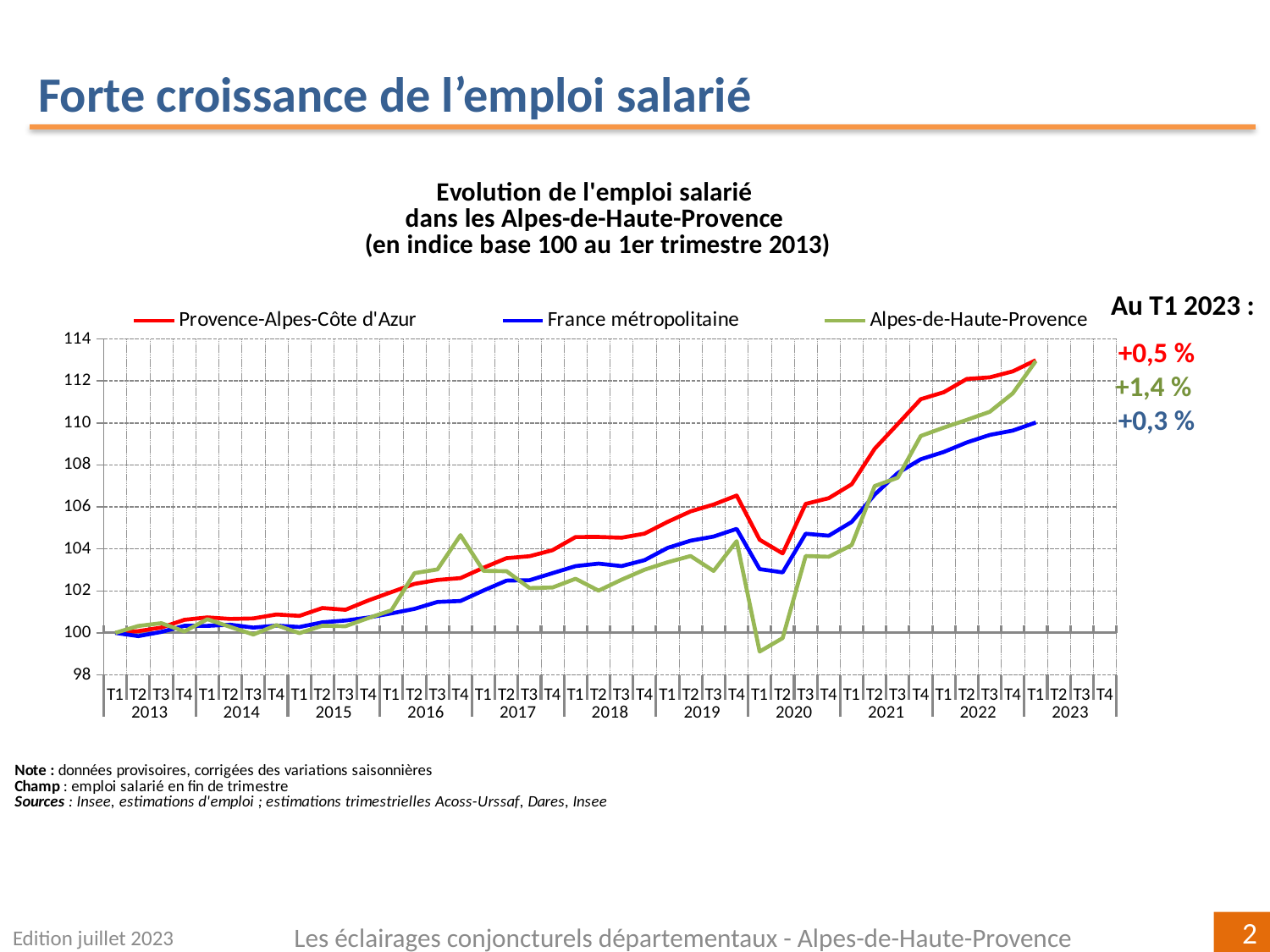
Which series falls to the lowest value during 2020? Alpes-de-Haute-Provence Is the value for Provence-Alpes-Côte d'Azur at T1 2023 greater or less than 112? greater At T1 2023, which is higher: Provence-Alpes-Côte d'Azur or France métropolitaine? Provence-Alpes-Côte d'Azur What kind of chart is shown on the slide? line chart How many series does the legend list? 3 According to the annotation at T1 2023, what is the change for Provence-Alpes-Côte d'Azur? +0,5 % Which series is drawn in green in the chart? Alpes-de-Haute-Provence According to the annotation at T1 2023, what is the change for Alpes-de-Haute-Provence? +1,4 % Is the value for France métropolitaine at T1 2023 greater or less than 108? greater Is the value for Alpes-de-Haute-Provence at T1 2020 greater or less than 100? less According to the annotation at T1 2023, what is the change for France métropolitaine? +0,3 % Overall, do the values rise or fall from 2013 to 2023? rise